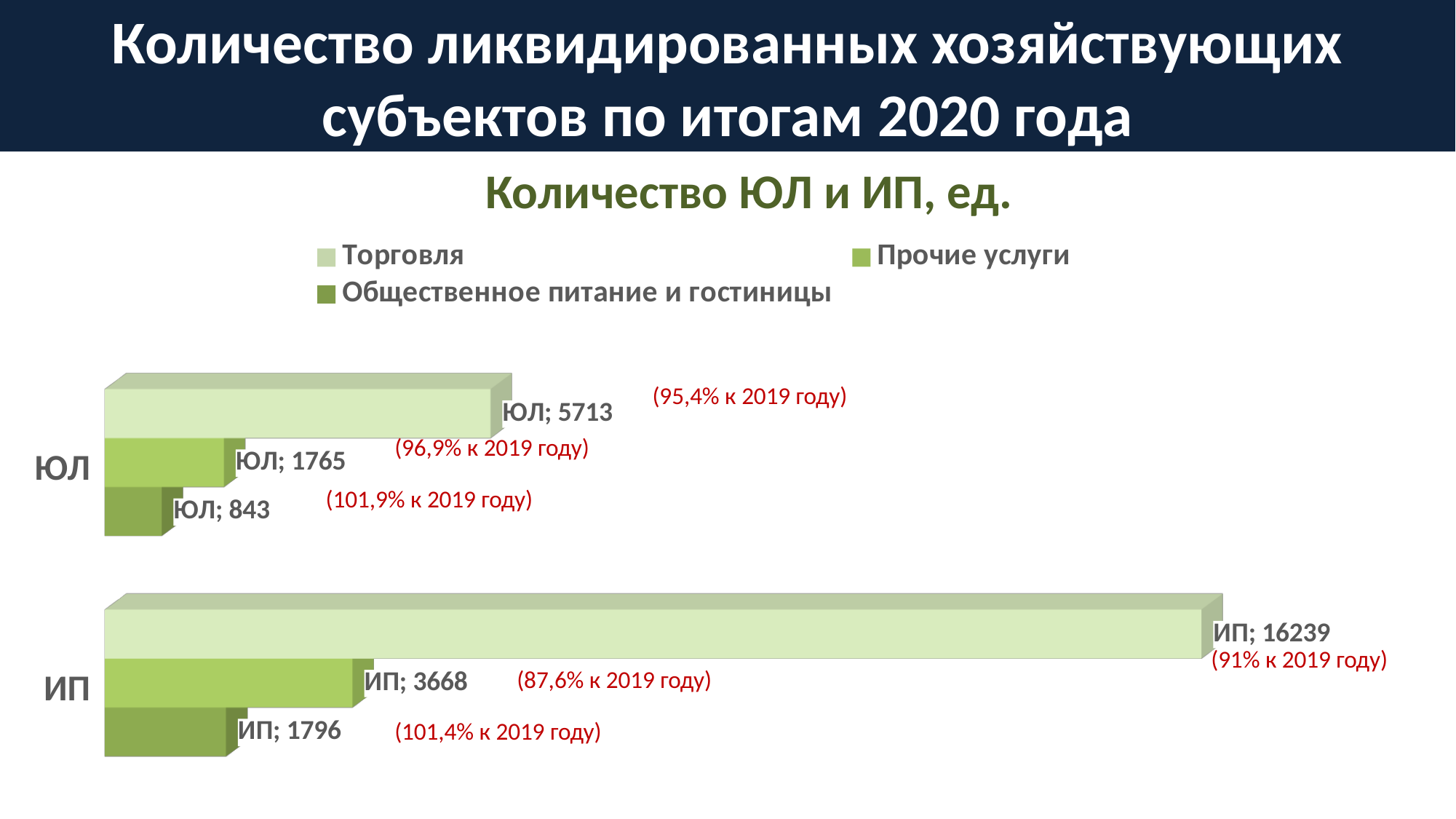
What is the value for Торговля in the ИП category? 16239 Which is larger: Прочие услуги for ЮЛ or Общественное питание и гостиницы for ИП? Общественное питание и гостиницы for ИП Which series has the lowest value in the ЮЛ category? Общественное питание и гостиницы What kind of chart is shown on the slide? Bar chart How many categories are shown on the chart? 2 What is the value for Общественное питание и гостиницы in the ЮЛ category? 843 What is the value for Прочие услуги in the ИП category? 3668 What is the difference between Прочие услуги and Общественное питание и гостиницы in the ИП category? 1872 What is the difference between the Торговля values for ИП and ЮЛ? 10526 How many series does the legend list? 3 Which series has the highest value in the ИП category? Торговля What is the value for Торговля in the ЮЛ category? 5713